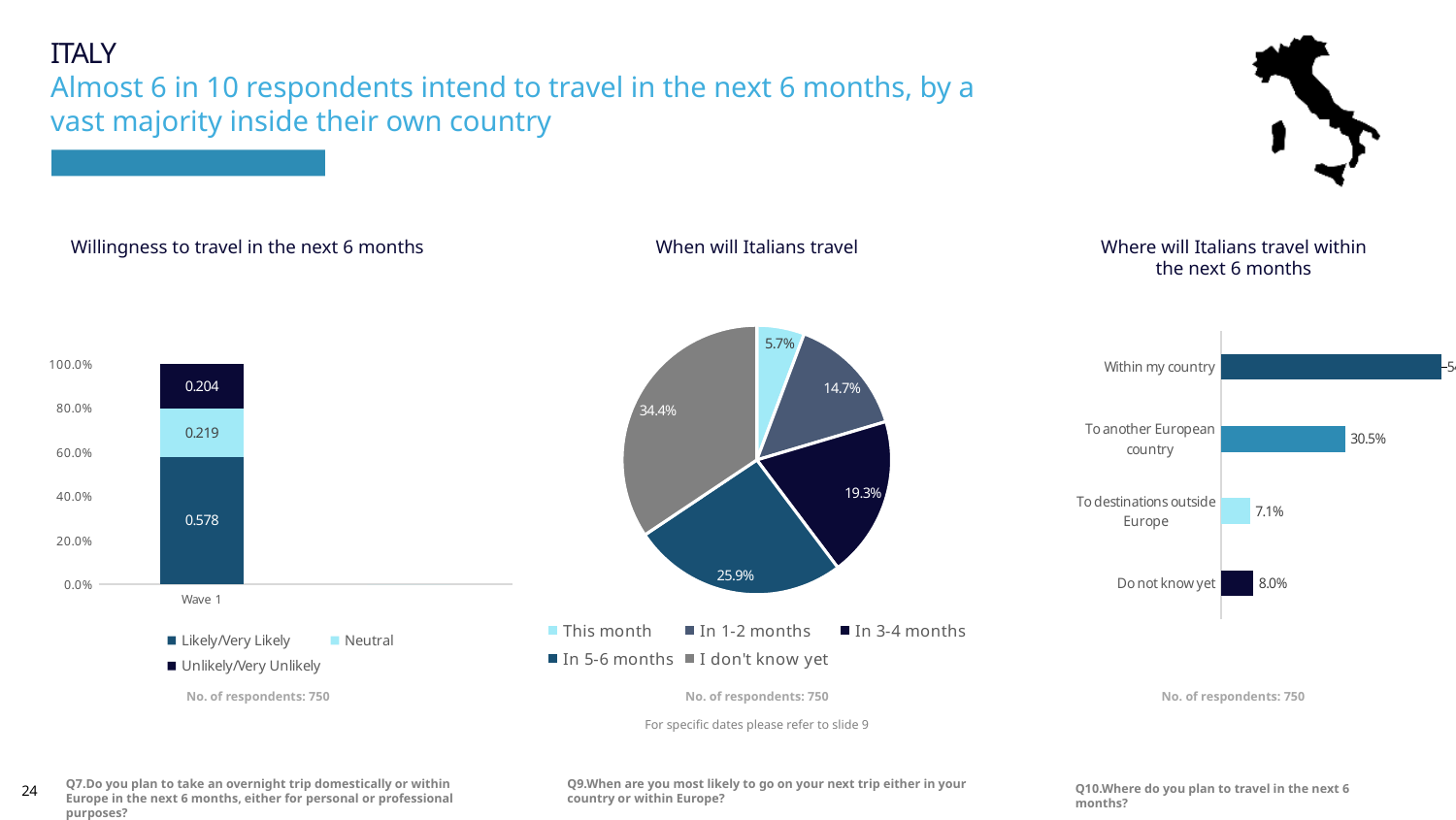
In the 'Willingness to travel in the next 6 months' chart, what is the value for Neutral? 0.219 In the 'When will Italians travel' chart, which category has the largest slice? I don't know yet In the 'Willingness to travel in the next 6 months' chart, what is the value for Unlikely/Very Unlikely? 0.204 In the 'When will Italians travel' chart, which is larger: 'In 1-2 months' or 'In 3-4 months'? In 3-4 months In the 'When will Italians travel' chart, what share of respondents said 'This month'? 5.7% In the 'Where will Italians travel within the next 6 months' chart, what is the value for 'To another European country'? 30.5% In the 'Willingness to travel in the next 6 months' chart, how many series does the legend list? 3 In the 'When will Italians travel' chart, what share of respondents said 'In 5-6 months'? 25.9% In the 'Where will Italians travel within the next 6 months' chart, which category has the lowest value? To destinations outside Europe In the 'Willingness to travel in the next 6 months' chart, what is the difference between the Likely/Very Likely and Neutral values? 0.359 In the 'Willingness to travel in the next 6 months' chart, what is the value for Likely/Very Likely in Wave 1? 0.578 What kind of chart is 'When will Italians travel'? Pie chart